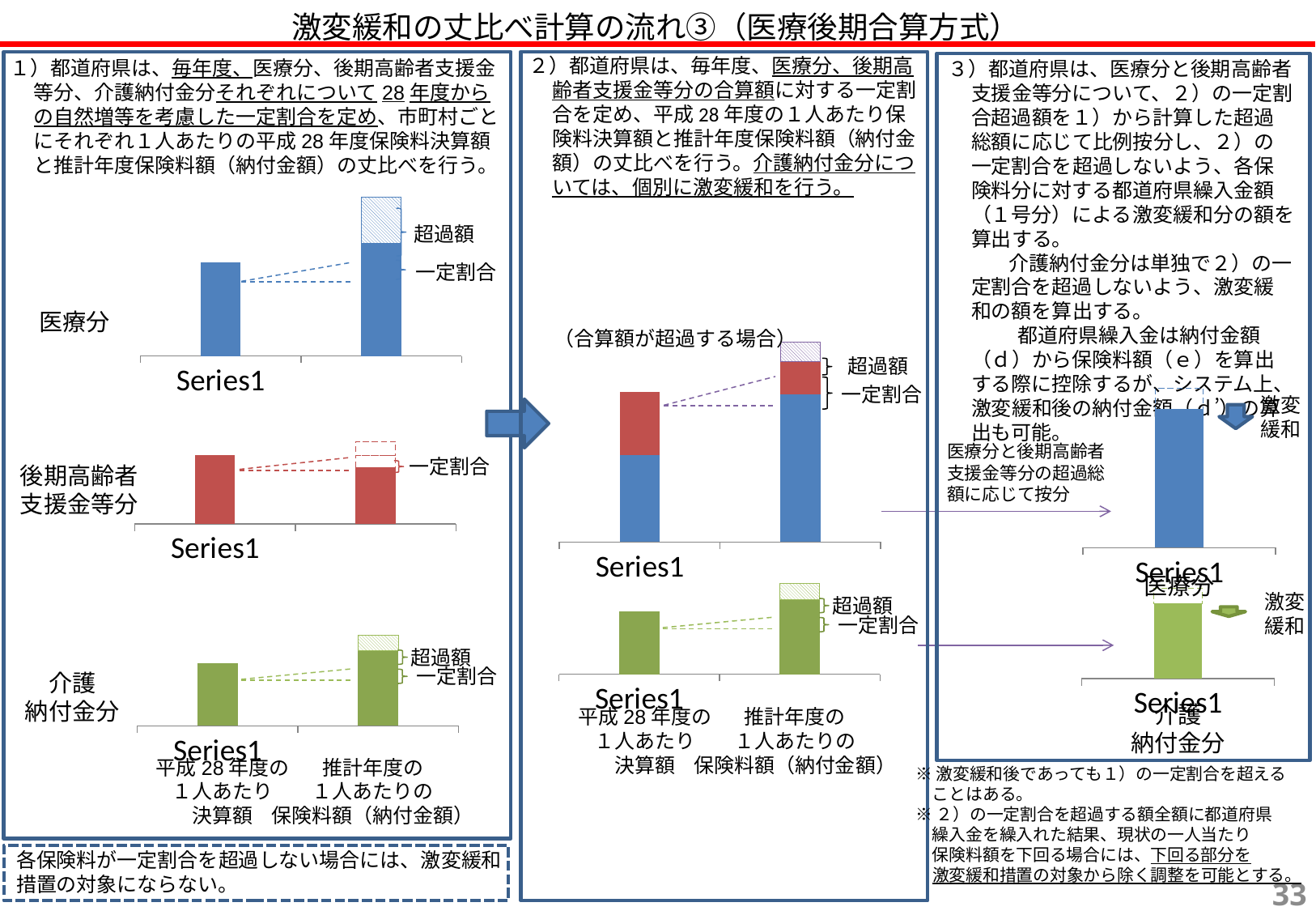
What series label appears beneath the charts on the slide? Series1 In the middle panel (2), how many bars does the stacked chart labelled 合算額が超過する場合 contain? 2 In the 医療分 chart in the left panel (1), which bar is taller: 平成28年度の1人あたり決算額 or 推計年度の1人あたりの保険料額（納付金額）? 推計年度の1人あたりの保険料額（納付金額） In the 医療分 chart in the left panel (1), how many bars are plotted? 2 In the right panel (3), how many bars does the 医療分 chart show? 1 In the right panel (3), what colour is the bar in the 介護納付金分 chart? green In the 医療分 chart in the left panel (1), what kind of chart is shown? bar chart In the middle panel (2), which bar of the stacked chart is taller: the left bar (平成28年度の1人あたり決算額) or the right bar (推計年度の1人あたりの保険料額（納付金額）)? the right bar (推計年度の1人あたりの保険料額（納付金額）) In the left panel (1), does the 介護納付金分 chart rise or fall from the left bar to the right bar? rise In the left panel (1), what colour are the bars of the 後期高齢者支援金等分 chart? red In the right panel (3), what kind of chart is the 介護納付金分 chart? bar chart